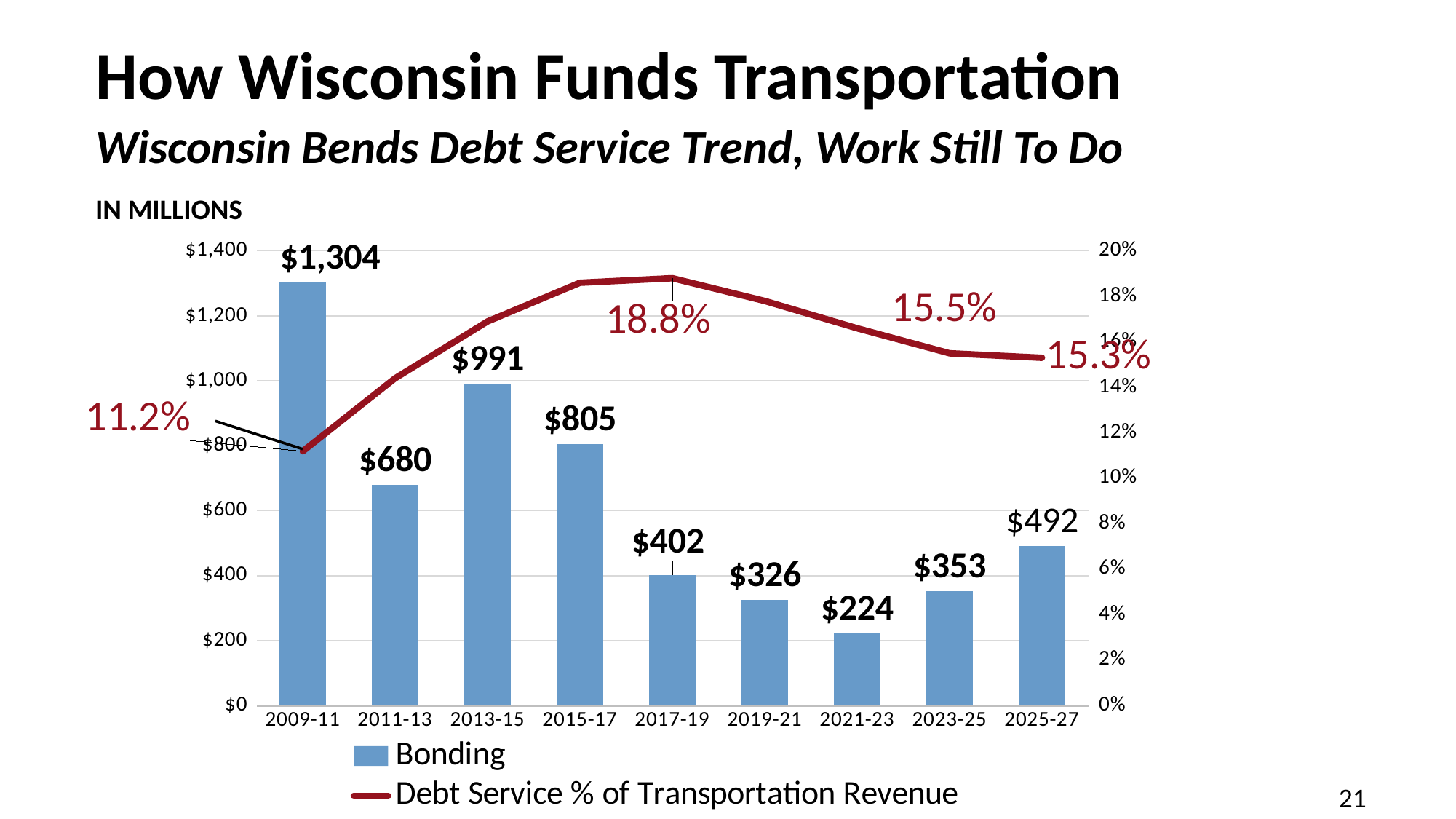
Is the Debt Service % of Transportation Revenue for 2013-15 greater or less than 14%? greater What unit are the Bonding values shown in, according to the label above the chart? In millions Which is larger, the Bonding value for 2023-25 or for 2025-27? 2025-27 What is the Debt Service % of Transportation Revenue for 2025-27? 15.3% Which period has the highest Bonding value? 2009-11 What is the difference between the Bonding values for 2013-15 and 2015-17? $186 What is the Debt Service % of Transportation Revenue for 2017-19? 18.8% How many periods are shown on the x axis? 9 What is the Bonding value for 2021-23? $224 What is the Bonding value for 2009-11? $1,304 How many series does the legend list? 2 Which period has the lowest Bonding value? 2021-23